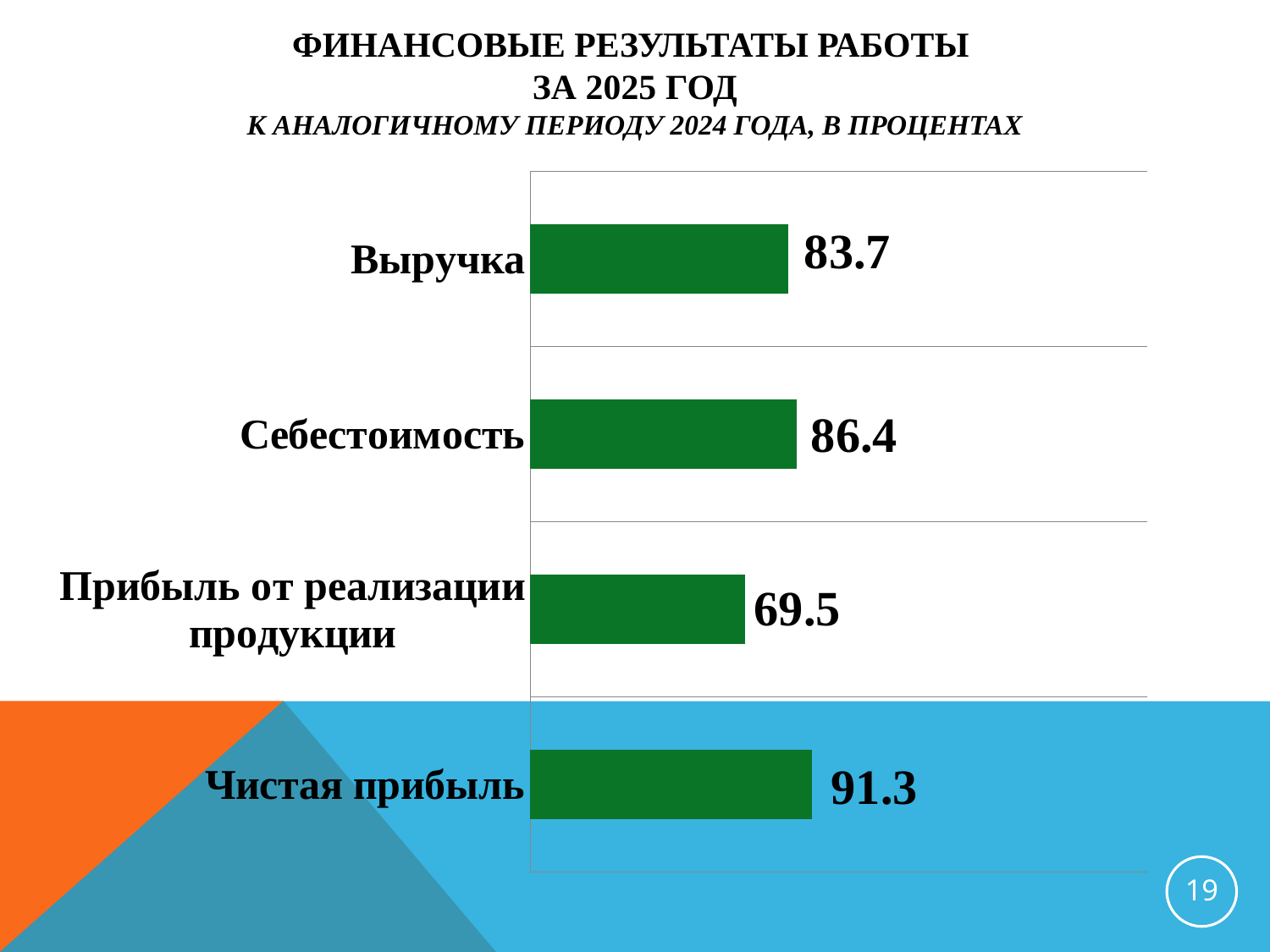
What colour are the bars in the chart? Green What kind of chart is shown on the slide? Bar chart What is the value for Себестоимость? 86.4 What is the value for Выручка? 83.7 What is the difference between the values for Чистая прибыль and Прибыль от реализации продукции? 21.8 What is the difference between the values for Себестоимость and Выручка? 2.7 Which category has the highest value? Чистая прибыль What is the value for Чистая прибыль? 91.3 How many categories are shown in the chart? 4 What is the value for Прибыль от реализации продукции? 69.5 Which is larger, the value for Себестоимость or the value for Выручка? Себестоимость Which category has the lowest value? Прибыль от реализации продукции